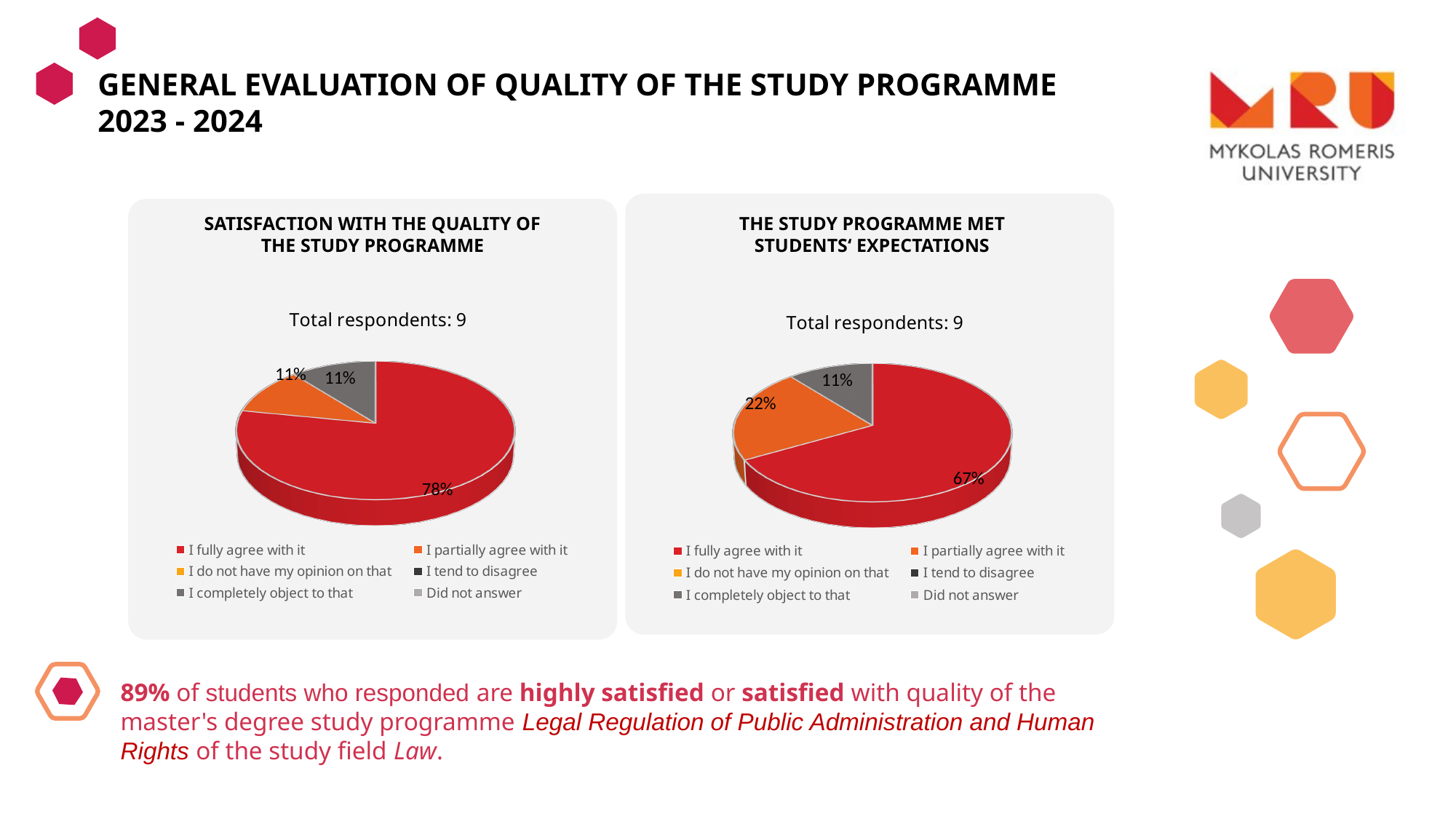
How many entries does the legend of the 'The study programme met students' expectations' chart list? 6 Which chart has the larger 'I partially agree with it' share: the left chart or the right chart? The right chart (The study programme met students' expectations) In the 'The study programme met students' expectations' chart, what share of respondents fully agree with it? 67% What is the difference between the 'I fully agree with it' share in the left chart (78%) and in the right chart (67%)? 11% In the 'The study programme met students' expectations' chart, what share of respondents completely object to that? 11% In the 'The study programme met students' expectations' chart, which response has the largest share? I fully agree with it In the 'Satisfaction with the quality of the study programme' chart, which response has the largest share? I fully agree with it In the 'The study programme met students' expectations' chart, what share of respondents partially agree with it? 22% In the 'The study programme met students' expectations' chart, which response has the smallest share? I completely object to that What type of chart is used in the 'Satisfaction with the quality of the study programme' panel? Pie chart In the 'Satisfaction with the quality of the study programme' chart, what share of respondents fully agree with it? 78% In the 'Satisfaction with the quality of the study programme' chart, what share of respondents partially agree with it? 11%